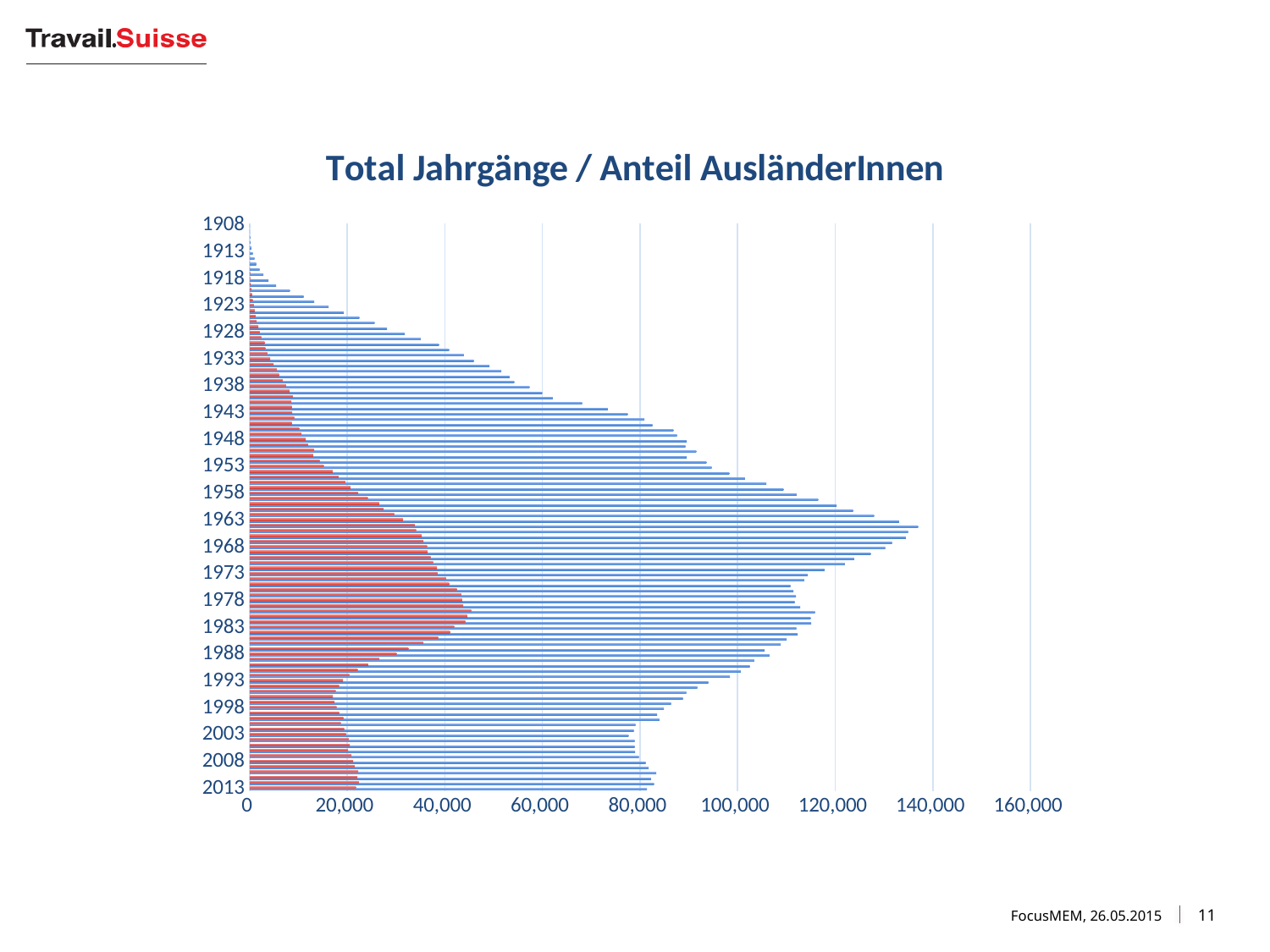
Is the blue bar for 1998 greater or less than 100,000? less Is the blue bar for 1913 greater or less than 20,000? less Is the blue bar for 2013 greater or less than 60,000? greater What is the highest value labelled on the horizontal axis? 160,000 What is the title of the chart? Total Jahrgänge / Anteil AusländerInnen What kind of chart is shown on the slide? bar chart Do the blue bars rise or fall from 1908 to 1963? rise Which is larger, the blue bar for 1963 or the blue bar for 2013? 1963 Which is larger, the red bar for 1978 or the red bar for 1933? 1978